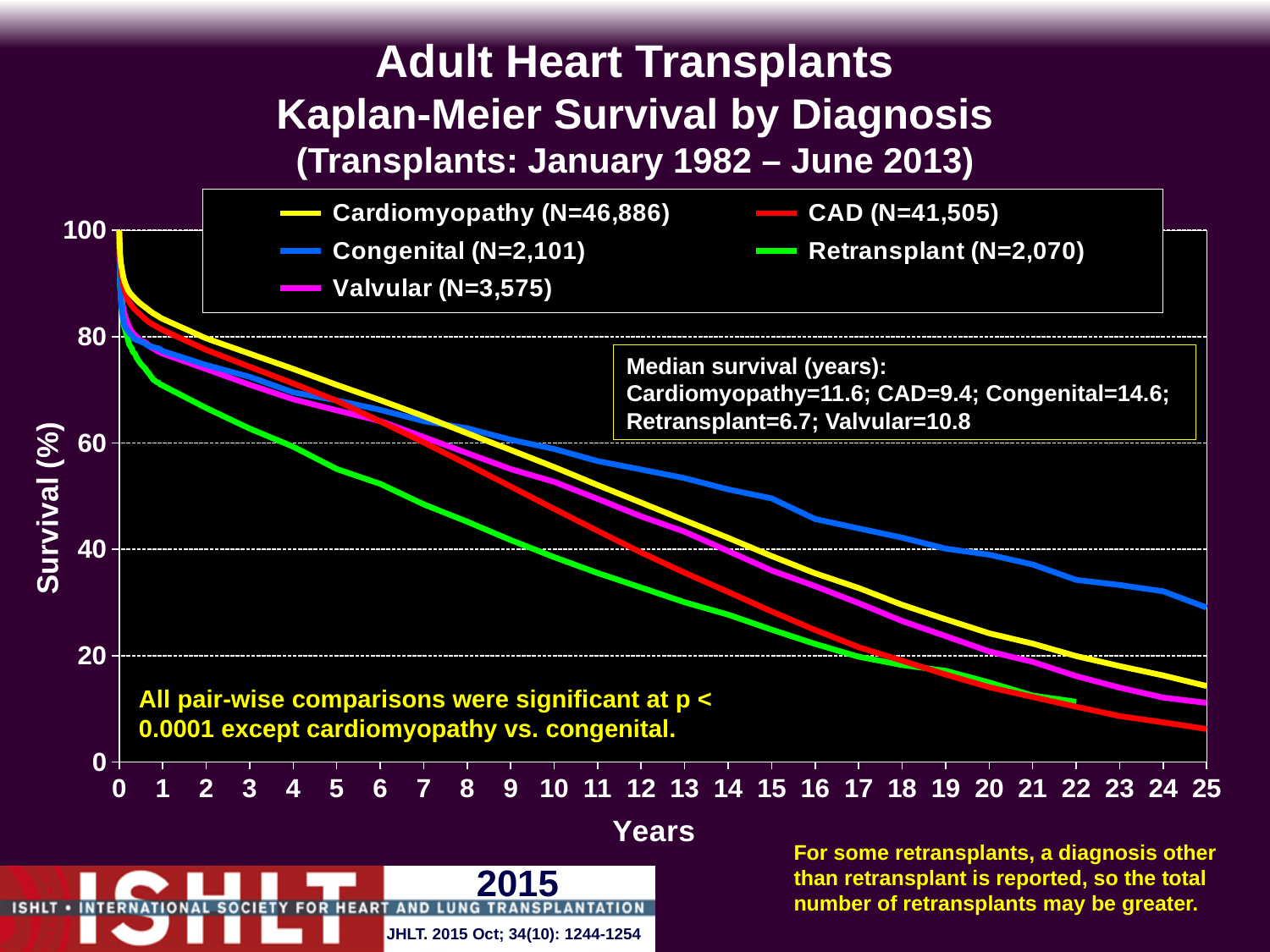
What is the median survival in years for the Congenital group? 14.6 Do the survival curves rise or fall as years increase along the x axis? Fall At 20 years, which group has higher survival: Congenital or Retransplant? Congenital How many patients (N) are in the Valvular group according to the legend? 3,575 Is the survival for the CAD group at 25 years greater or less than 10%? less How many diagnosis groups (series) does the legend list? 5 Which diagnosis group has the lowest median survival? Retransplant Is the survival for the Congenital group at 25 years greater or less than 20%? greater What is the median survival in years for the Retransplant group? 6.7 Which diagnosis group has the highest median survival? Congenital What is the difference in median survival (years) between Cardiomyopathy and CAD? 2.2 What type of chart is shown on the slide? Line chart